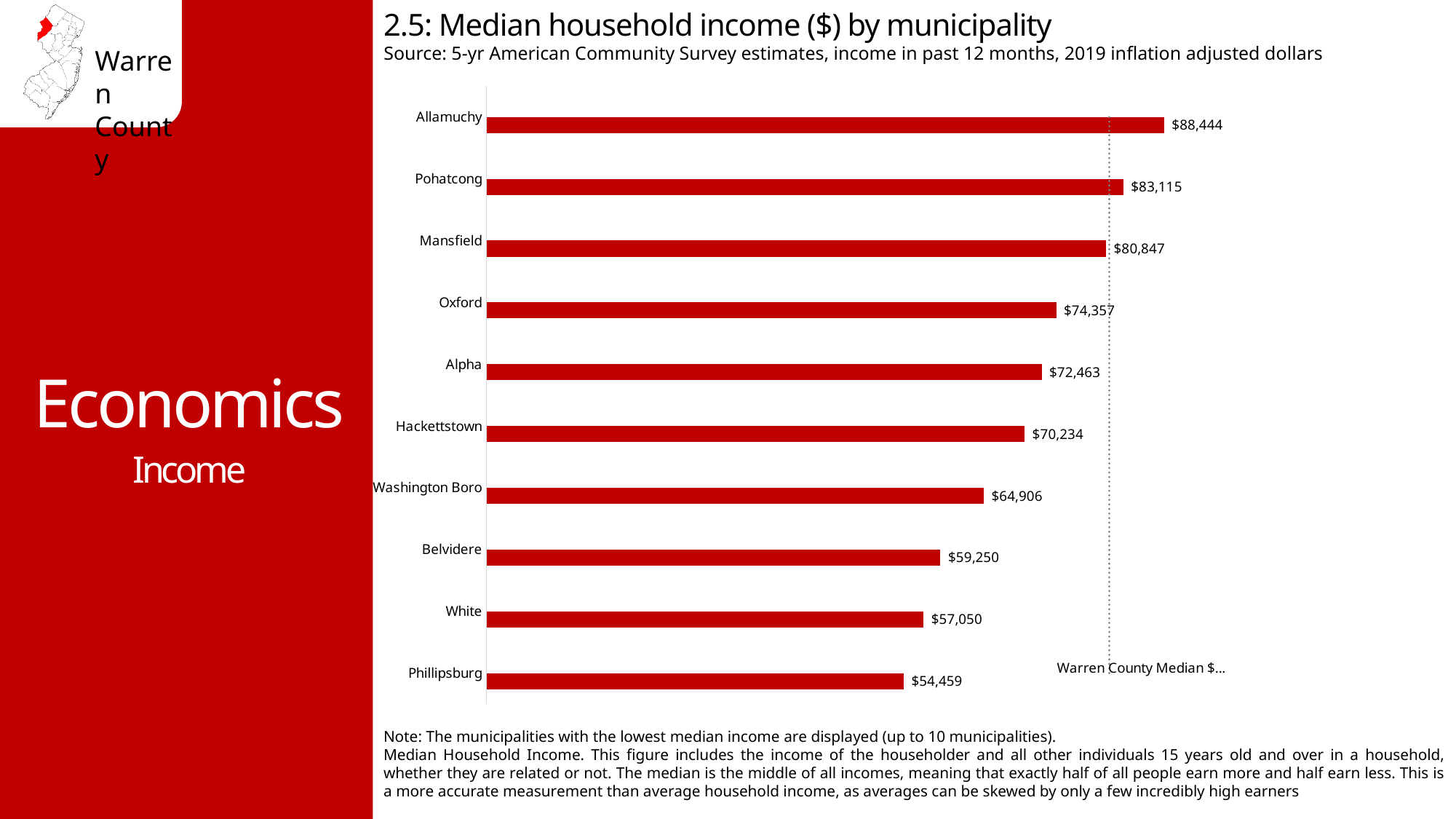
Which municipality has the highest median household income on the chart? Allamuchy How many municipalities are shown on the chart? 10 What is the difference in median household income between Allamuchy and Phillipsburg? $33,985 What is the median household income for Allamuchy? $88,444 Which municipality has the lowest median household income on the chart? Phillipsburg Which has a higher median household income, White or Belvidere? Belvidere What is the median household income for Washington Boro? $64,906 What is the median household income for Phillipsburg? $54,459 What type of chart is used to show median household income by municipality? Bar chart Which has a higher median household income, Oxford or Alpha? Oxford What is the difference in median household income between Pohatcong and Mansfield? $2,268 What is the median household income for Hackettstown? $70,234